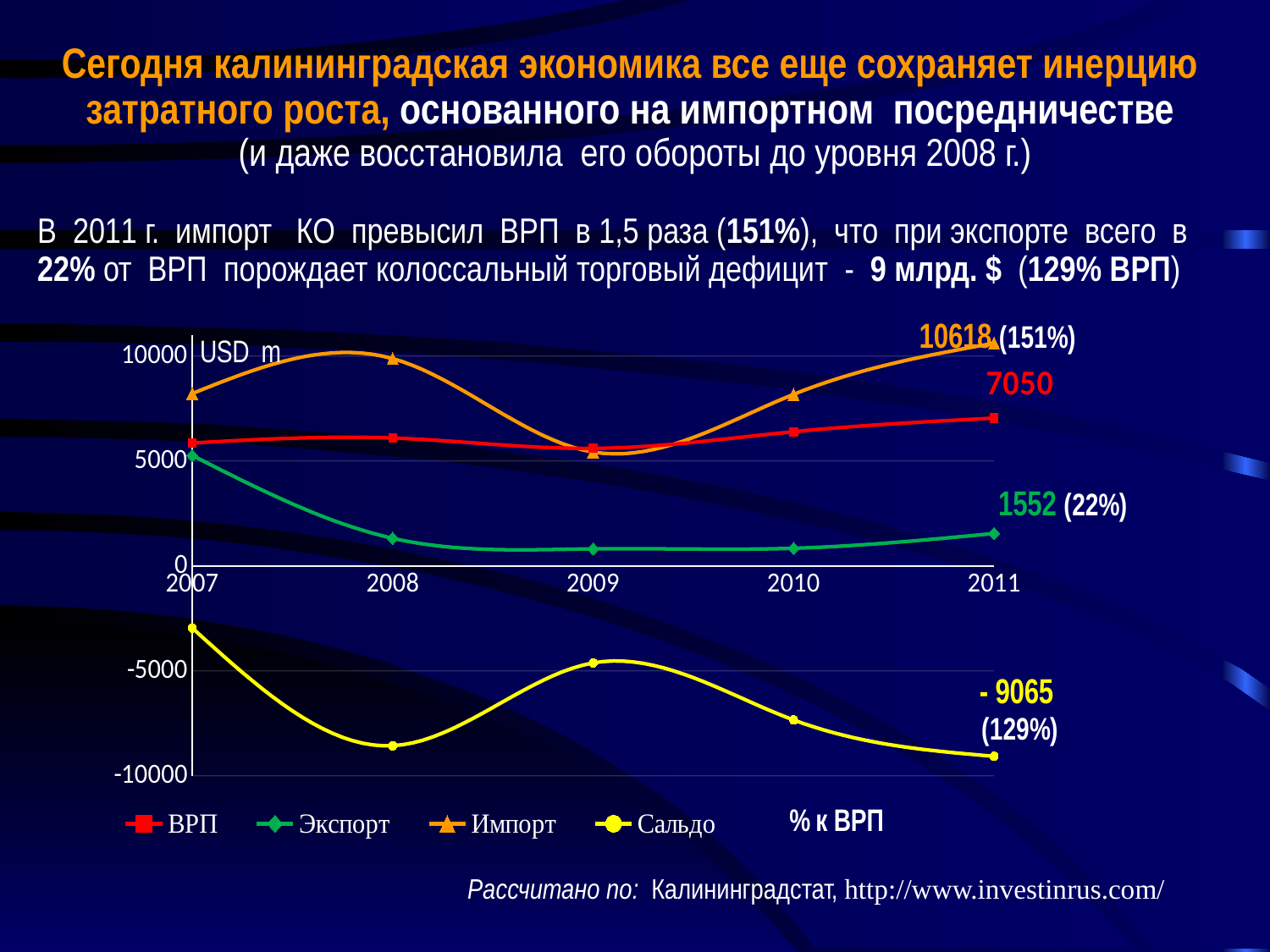
What is the difference between Импорт and ВРП in 2011? 3568 What is the value of ВРП in 2011? 7050 What is the value of Экспорт in 2011? 1552 Is the value for Импорт in 2008 greater or less than 5000? greater What is the value of Сальдо in 2011? - 9065 How many series does the legend list? 4 How many years are shown on the x axis? 5 What kind of chart is shown on the slide? line chart What unit is shown at the top of the y axis? USD m What is the value of Импорт in 2011? 10618 Which series has the highest value in 2011? Импорт Does Импорт rise or fall from 2009 to 2011? rise